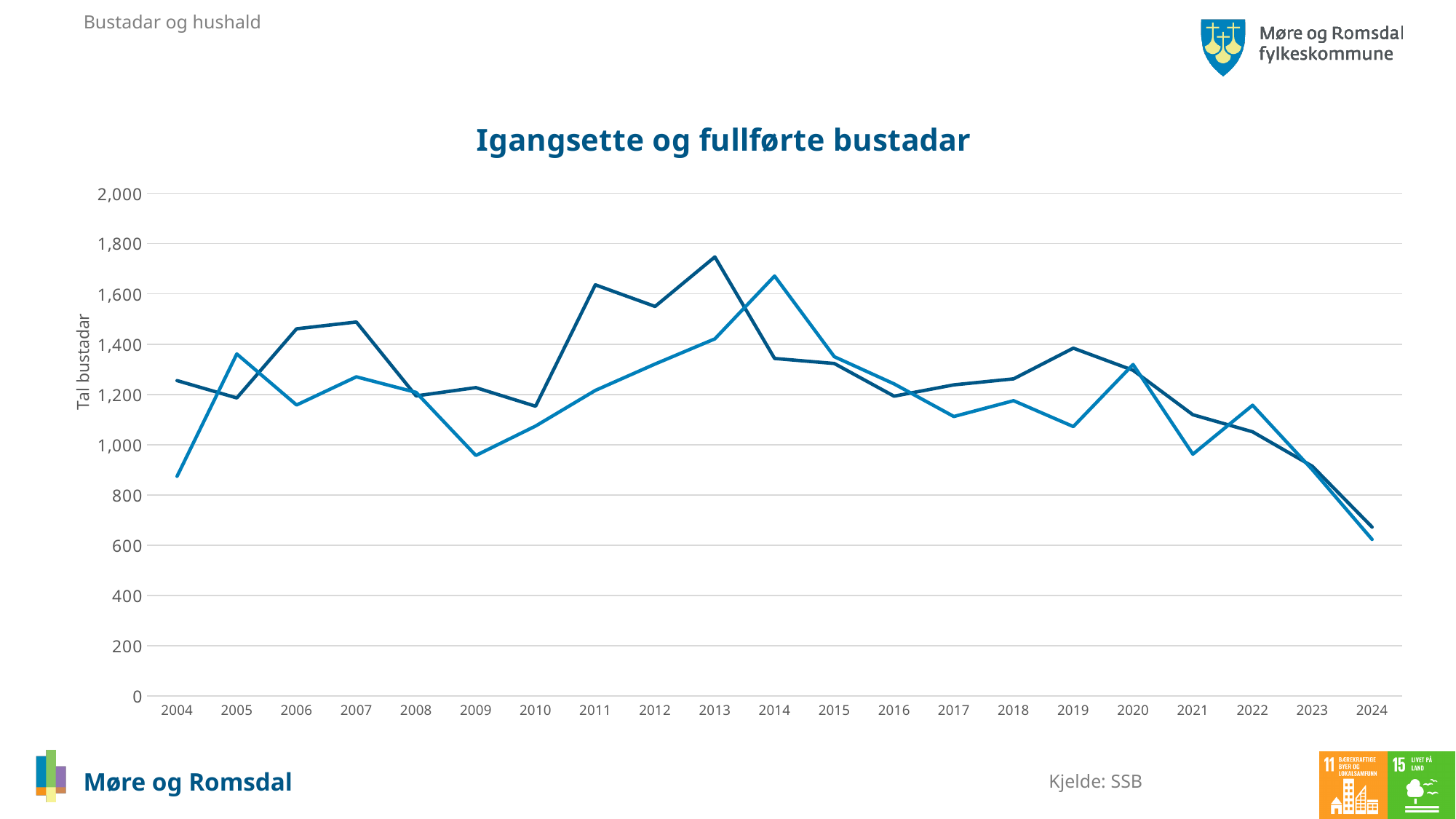
In which year does the light blue line reach its highest value? 2014 What kind of chart is shown on the slide? line chart What is the title of the chart? Igangsette og fullførte bustadar In 2014, which line has the higher value, the dark blue line or the light blue line? light blue line Is the value of the dark blue line in 2024 greater or less than 800? less Is the value of the light blue line in 2004 greater or less than 1,000? less Is the value of the dark blue line in 2013 greater or less than 1,600? greater How many years are plotted along the x axis of the chart? 21 What is the label on the vertical axis of the chart? Tal bustadar In which year does the dark blue line reach its highest value? 2013 In which year does the light blue line reach its lowest value? 2024 Do the values of the dark blue line rise or fall from 2020 to 2024? fall